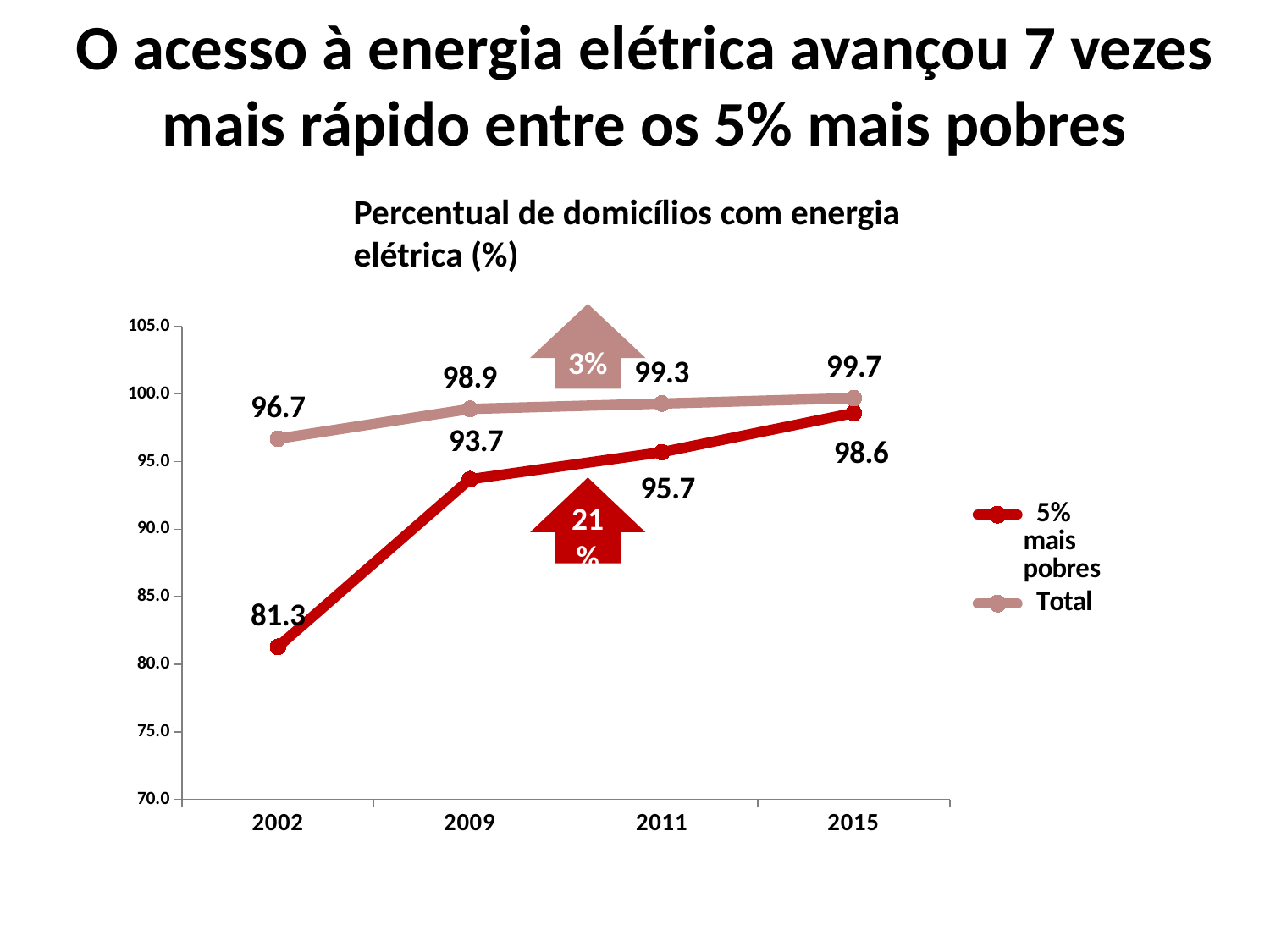
Which series has the larger value in 2009, "5% mais pobres" or "Total"? Total What is the value for "Total" in 2009? 98.9 How many series does the legend list? 2 What is the value for "5% mais pobres" in 2002? 81.3 In which year is the value for "Total" highest? 2015 Does the value for "5% mais pobres" rise or fall from 2002 to 2015? Rise What is the value for "5% mais pobres" in 2011? 95.7 What is the value for "Total" in 2015? 99.7 How many years are shown on the x axis? 4 In which year is the value for "5% mais pobres" lowest? 2002 What kind of chart is shown on the slide? Line chart What is the difference between the "Total" and "5% mais pobres" values in 2002? 15.4